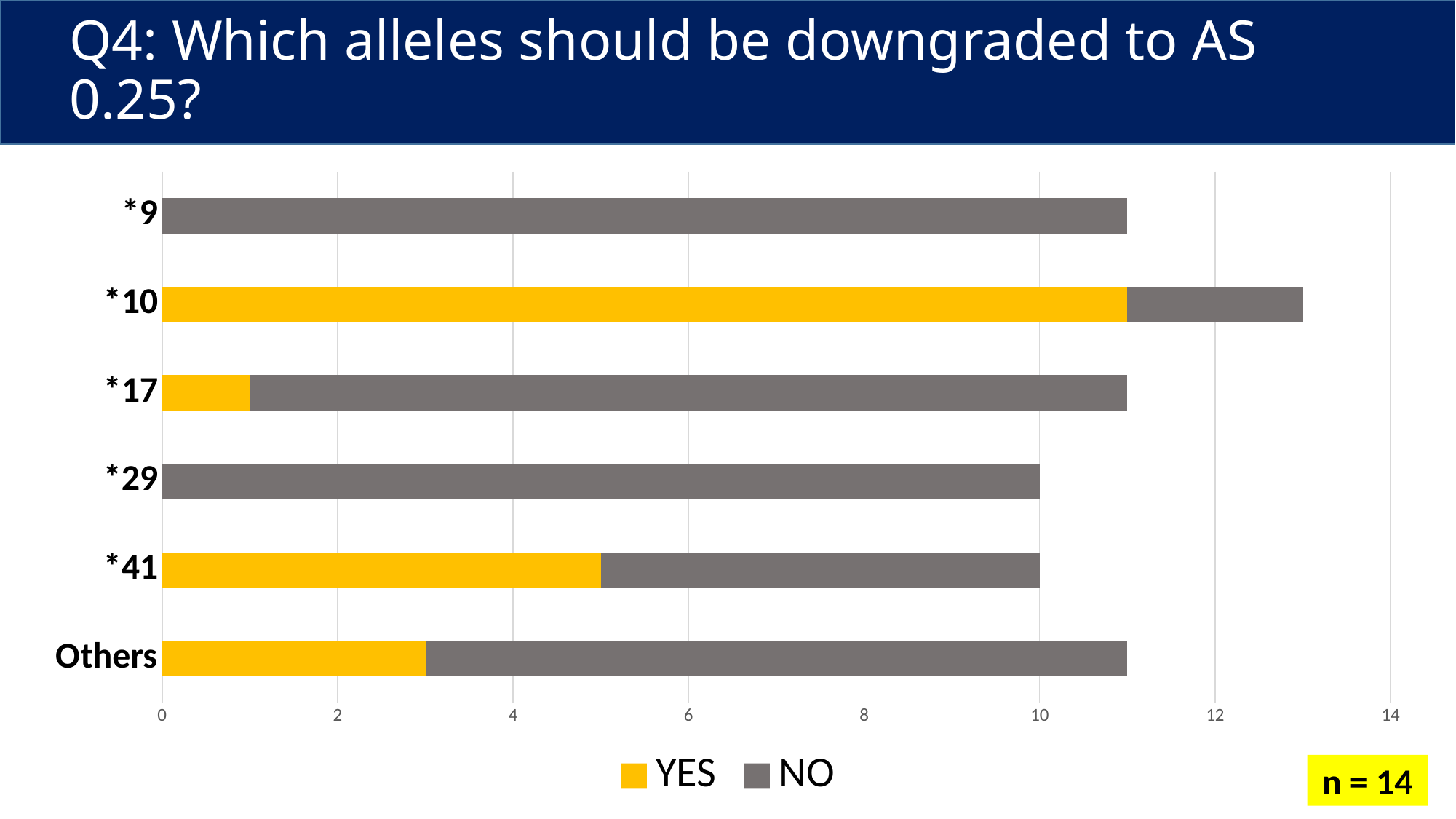
Is the YES value for *41 greater or less than 4? greater Which is larger, the YES value for *10 or the YES value for *41? *10 What are the two series named in the legend? YES and NO How many allele categories are shown on the chart? 6 How many series does the legend list? 2 Is the YES value for *17 greater or less than 2? less What kind of chart is shown on the slide? bar chart What sample size (n) is stated on the slide? n = 14 What is the NO value for *29? 10 Which allele has the longest total bar? *10 Which allele has the largest YES value? *10 Is the total bar for *10 greater or less than 12? greater